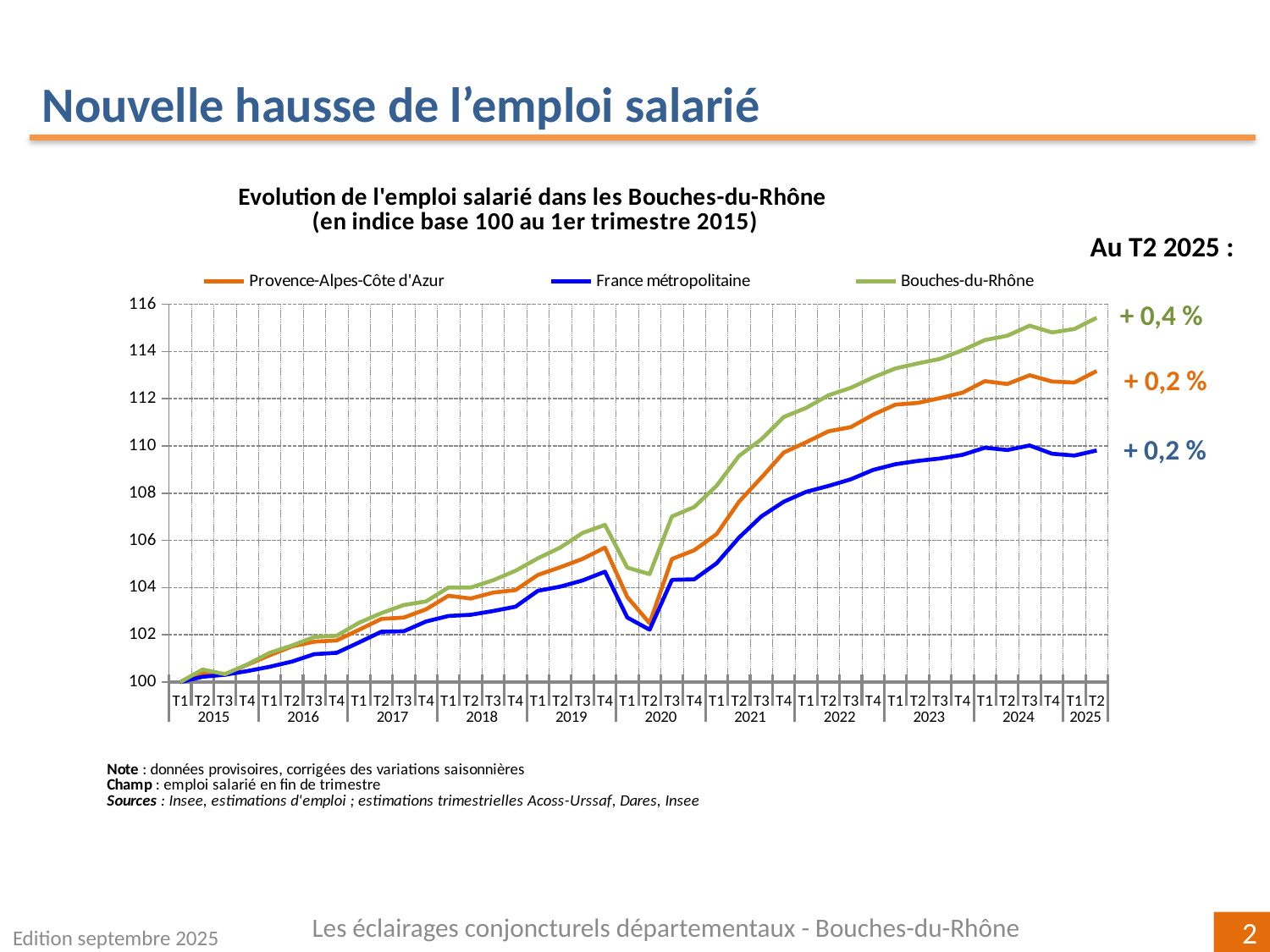
Is the value for France métropolitaine at T2 2025 greater or less than 112? less Overall, do the series rise or fall from 2015 to 2025? rise At T2 2020, which is higher: Bouches-du-Rhône or France métropolitaine? Bouches-du-Rhône Is the value for Bouches-du-Rhône at T2 2025 greater or less than 114? greater How many series does the legend list? 3 Which series has the lowest value at T2 2025? France métropolitaine Which series are listed in the legend? Provence-Alpes-Côte d'Azur, France métropolitaine, Bouches-du-Rhône What is the index value of all three series at T1 2015? 100 What change is annotated for Bouches-du-Rhône at T2 2025? + 0,4 % Is the value for Provence-Alpes-Côte d'Azur at T2 2025 greater or less than 112? greater Which series has the highest value at T2 2025? Bouches-du-Rhône What kind of chart is shown on the slide? line chart